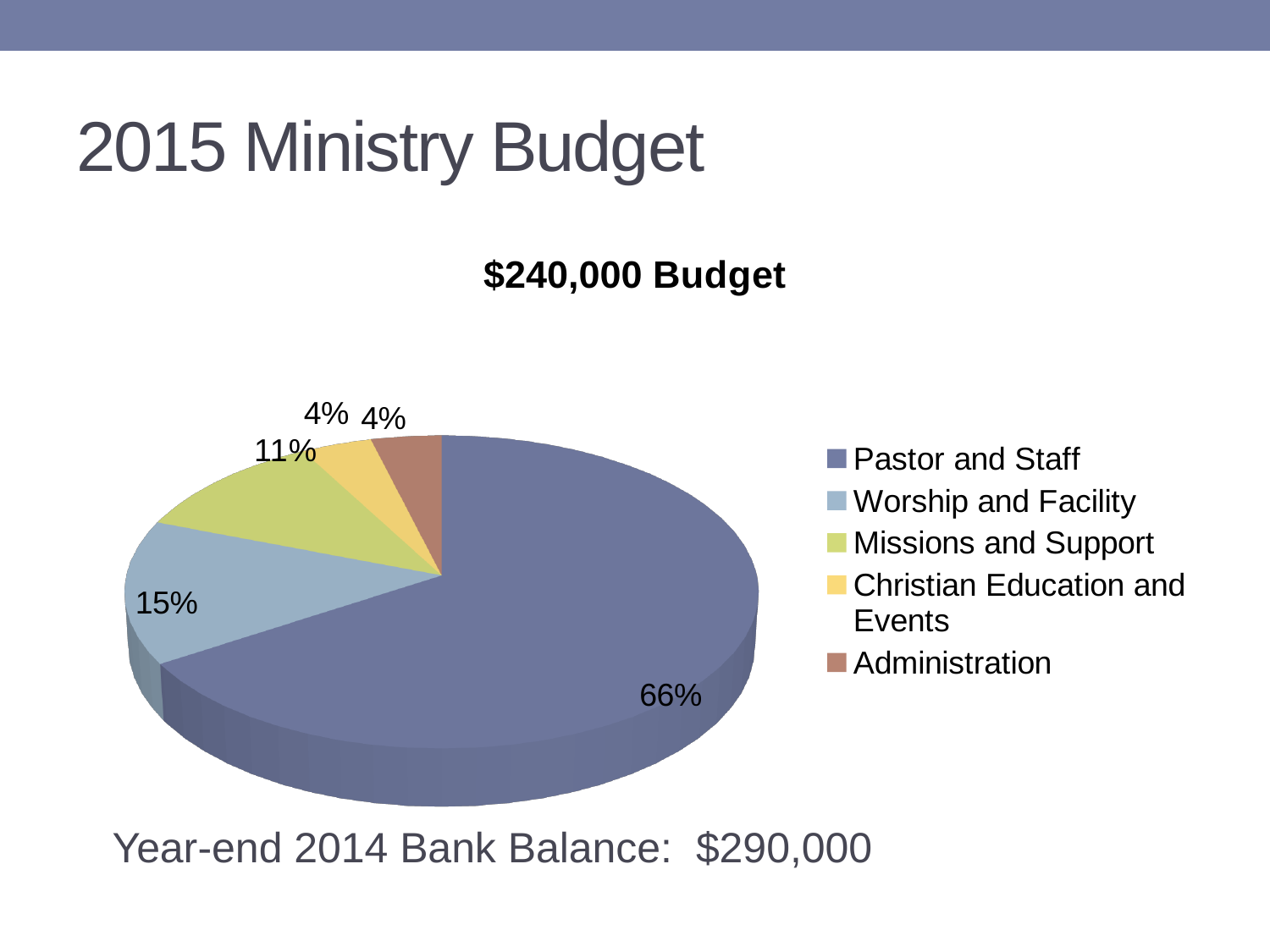
Which category has the largest share of the budget? Pastor and Staff What share of the budget goes to Missions and Support? 11% What is the title of the chart? $240,000 Budget What is the difference in percentage points between Pastor and Staff and Worship and Facility? 51 What share of the budget goes to Administration? 4% Which is larger, the share for Worship and Facility or the share for Missions and Support? Worship and Facility What share of the budget goes to Christian Education and Events? 4% Which category is shown in the yellow slice? Christian Education and Events What kind of chart is shown on the slide? Pie chart How many categories does the legend list? 5